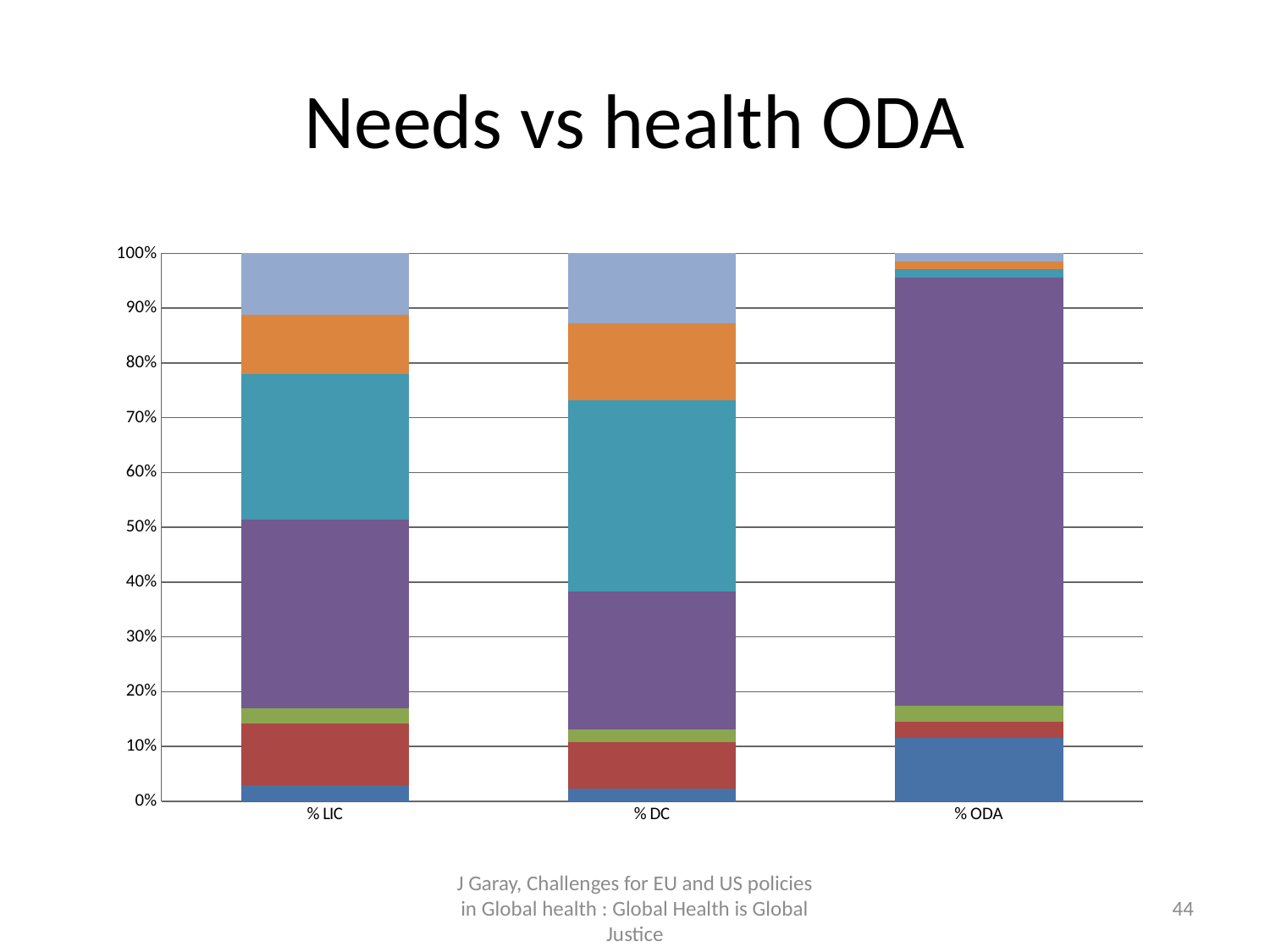
What is the maximum value shown on the y axis of the chart? 100% In the chart, which bar has the largest purple segment: % LIC, % DC or % ODA? % ODA What are the three category labels on the x axis of the chart? % LIC, % DC, % ODA How many categories are shown on the x axis of the chart? 3 What kind of chart is shown on the slide? stacked bar chart In the chart, is the top of the purple segment in the % DC bar greater or less than 40%? less In the chart, is the top of the purple segment in the % LIC bar greater or less than 50%? greater In the chart, is the top of the blue bottom segment in the % ODA bar greater or less than 10%? greater What is the title of the slide containing the chart? Needs vs health ODA